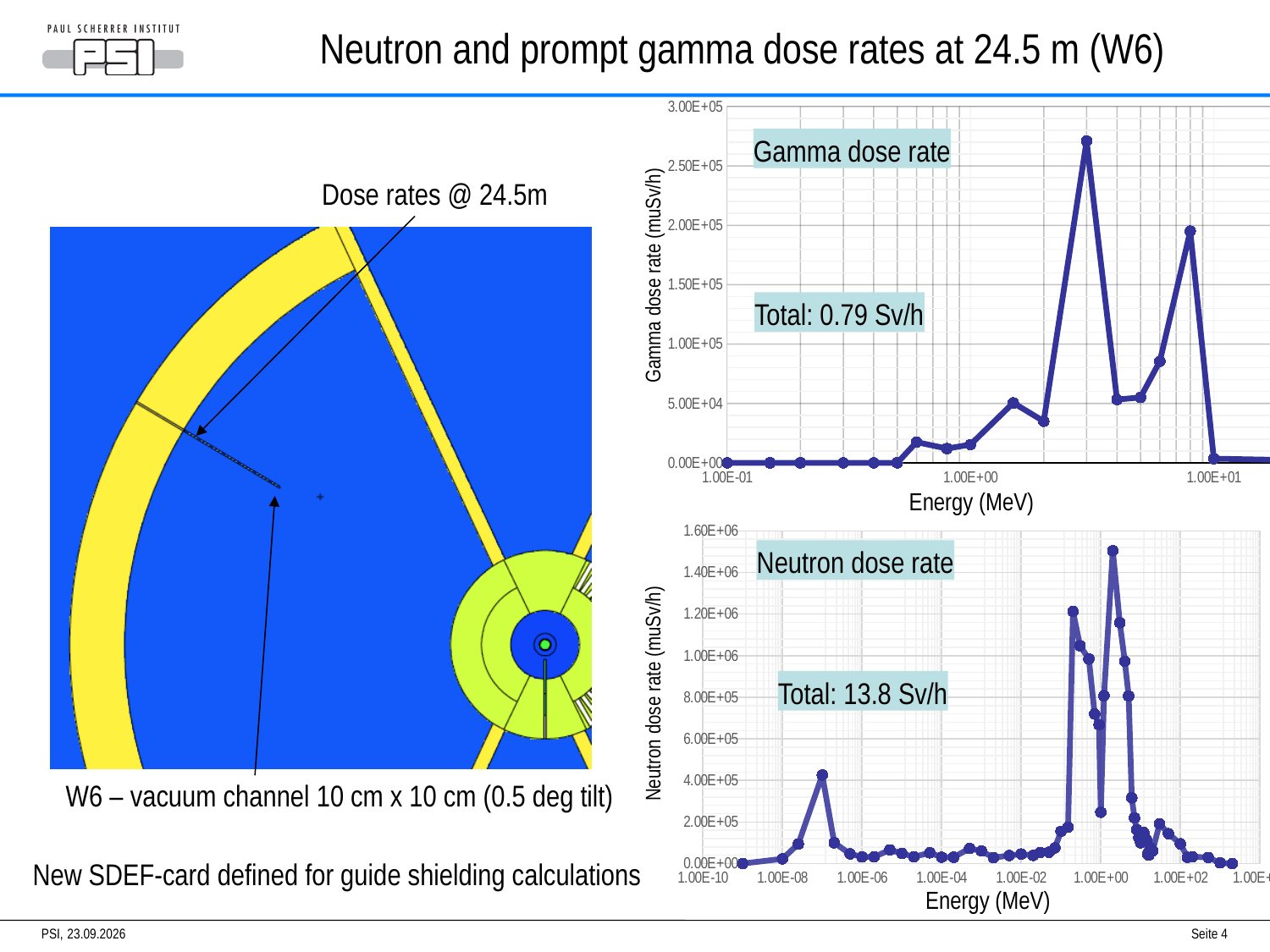
On the Neutron dose rate chart, is the highest peak greater or less than 1.40E+06 muSv/h? greater On the Neutron dose rate chart, is the value at 1.00E-04 MeV greater or less than 2.00E+05 muSv/h? less What total dose rate is stated on the Neutron dose rate chart? 13.8 Sv/h What kind of chart is the Gamma dose rate chart? line chart On the Neutron dose rate chart, which peak is larger: the one near 1.00E-07 MeV or the one near 1.00E+00 MeV? the one near 1.00E+00 MeV How many charts are shown on the slide? 2 What is the x-axis title of the Neutron dose rate chart? Energy (MeV) What total dose rate is stated on the Gamma dose rate chart? 0.79 Sv/h What kind of chart is the Neutron dose rate chart? line chart On the Gamma dose rate chart, is the value at 1.00E-01 MeV greater or less than 5.00E+04 muSv/h? less What is the y-axis title of the Gamma dose rate chart? Gamma dose rate (muSv/h)